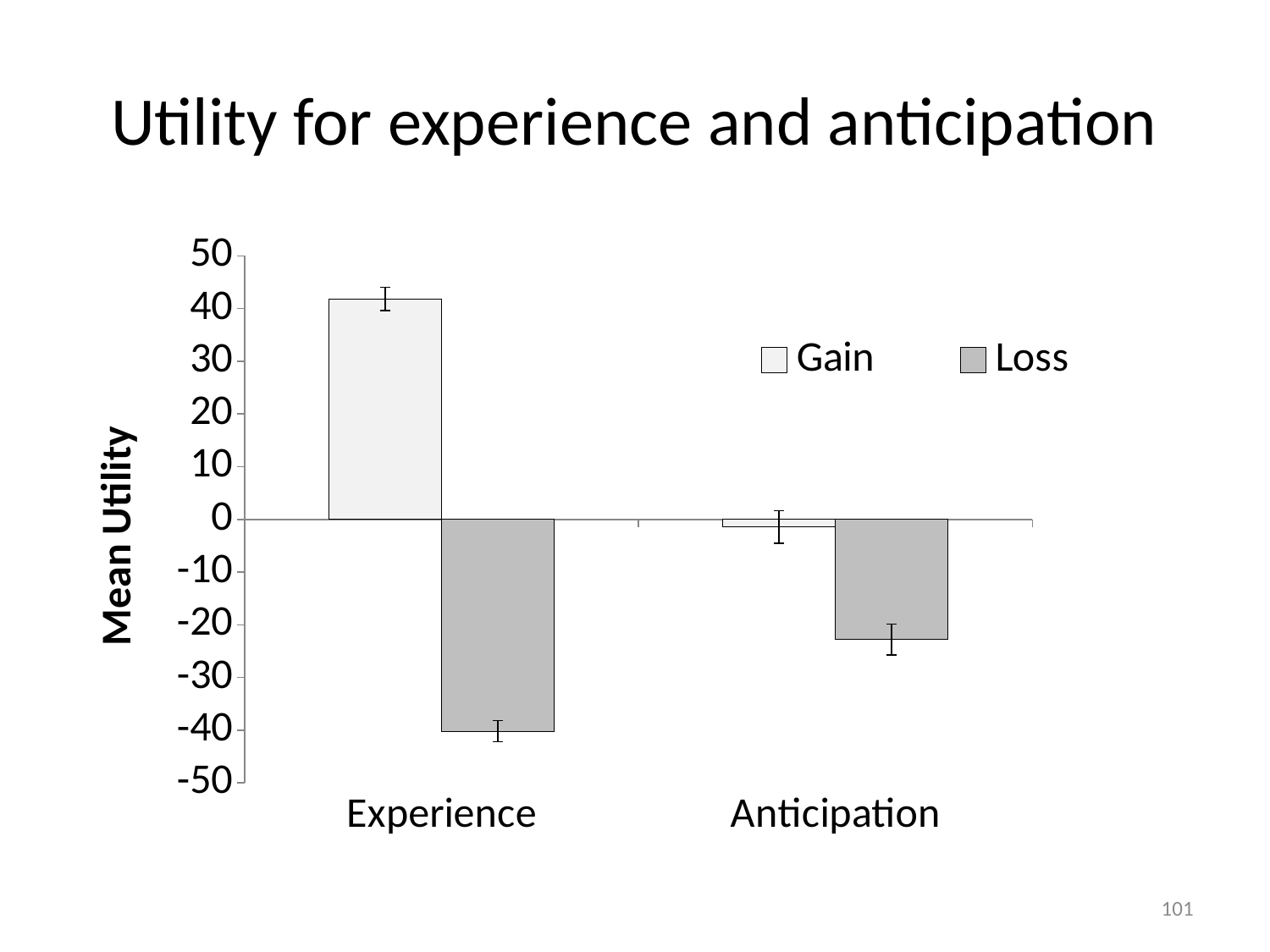
Which category has the more negative Loss value, Experience or Anticipation? Experience Is the Gain value for Anticipation greater or less than 10? less Which bar in the chart has the lowest (most negative) mean utility? Loss for Experience Is the Gain value for Experience greater or less than 30? greater Is the Loss value for Experience greater or less than -30? less What kind of chart is shown on the slide? bar chart How many series does the chart's legend list? 2 What are the two series named in the chart's legend? Gain and Loss Which bar in the chart has the highest mean utility? Gain for Experience How many categories are shown on the x axis of the chart? 2 What is the label of the vertical axis of the chart? Mean Utility